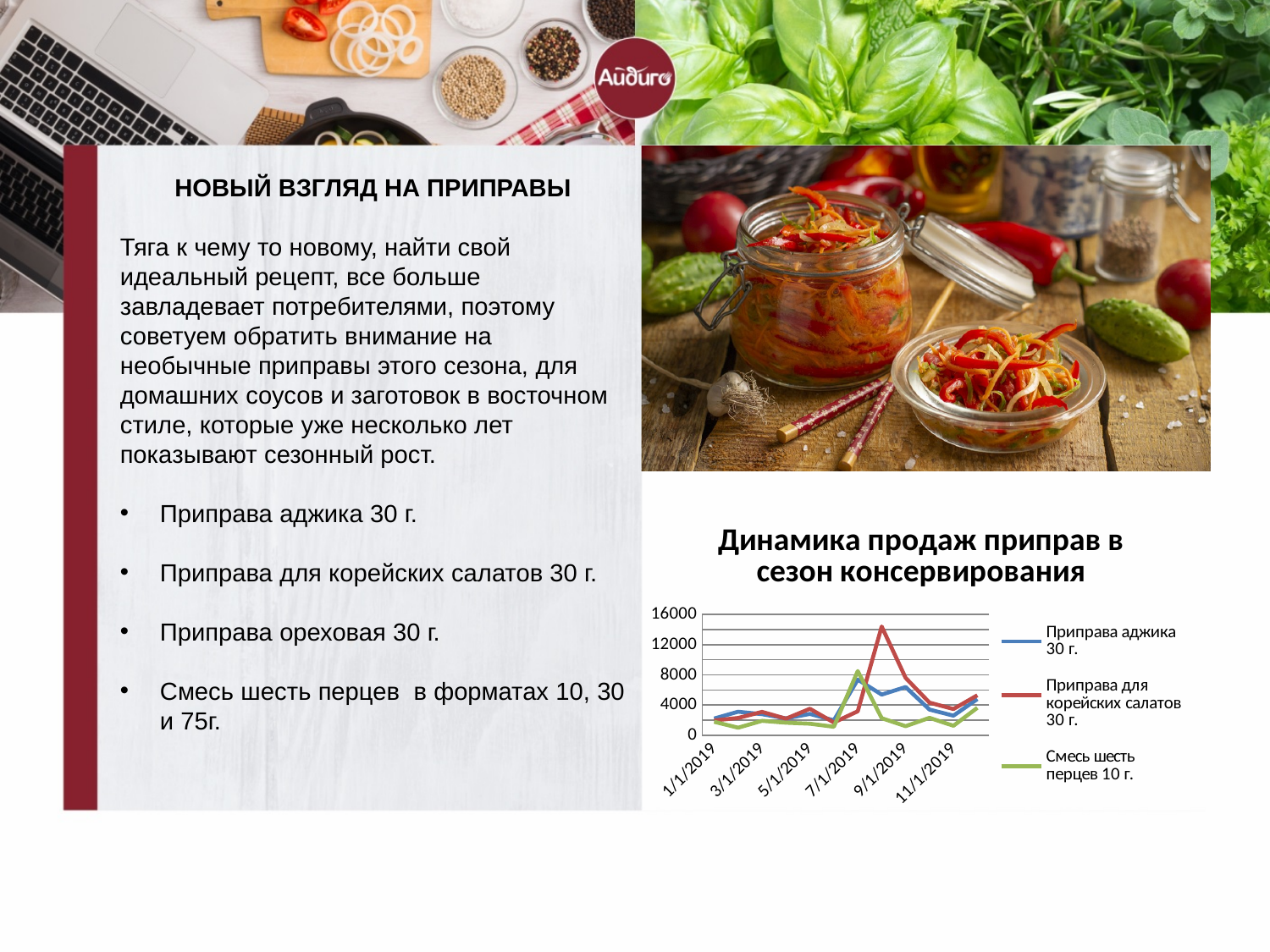
What kind of chart is shown under the title "Динамика продаж приправ в сезон консервирования"? line chart What is the title of the chart on the slide? Динамика продаж приправ в сезон консервирования How many date labels are shown along the x axis of the chart? 6 Which series is drawn in green on the chart? Смесь шесть перцев 10 г. How many series does the legend of the chart list? 3 Around 9/1/2019, which series has the larger value: "Приправа для корейских салатов 30 г." or "Смесь шесть перцев 10 г."? Приправа для корейских салатов 30 г. Is the peak value of the "Приправа для корейских салатов 30 г." line greater or less than 12000? greater Is the value of "Приправа аджика 30 г." at 1/1/2019 greater or less than 4000? less What is the highest value shown on the vertical axis of the chart? 16000 Which series reaches the highest peak on the chart? Приправа для корейских салатов 30 г. Is the value of "Смесь шесть перцев 10 г." at 1/1/2019 greater or less than 4000? less